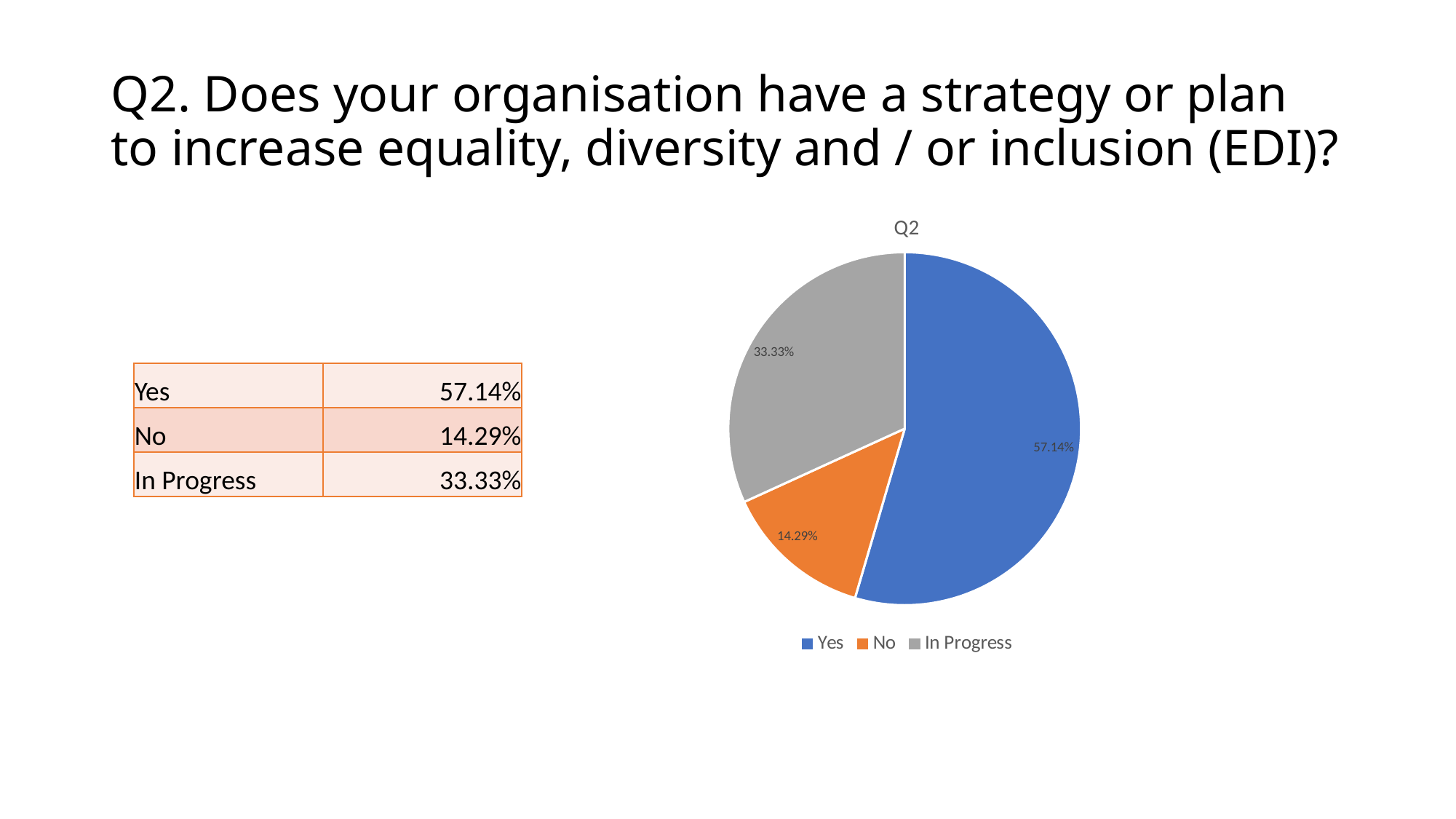
What share of the pie does the In Progress slice represent? 33.33% What share of the pie does the No slice represent? 14.29% What colour is the Yes slice in the pie chart? blue What is the chart's title? Q2 How many entries does the legend list? 3 How many slices does the pie chart have? 3 What is the difference in percentage points between the Yes slice and the In Progress slice? 23.81 What kind of chart is shown on the slide? pie chart Which category has the smallest slice of the pie? No What share of the pie does the Yes slice represent? 57.14% Which category has the largest slice of the pie? Yes Which is larger, the In Progress slice or the No slice? In Progress